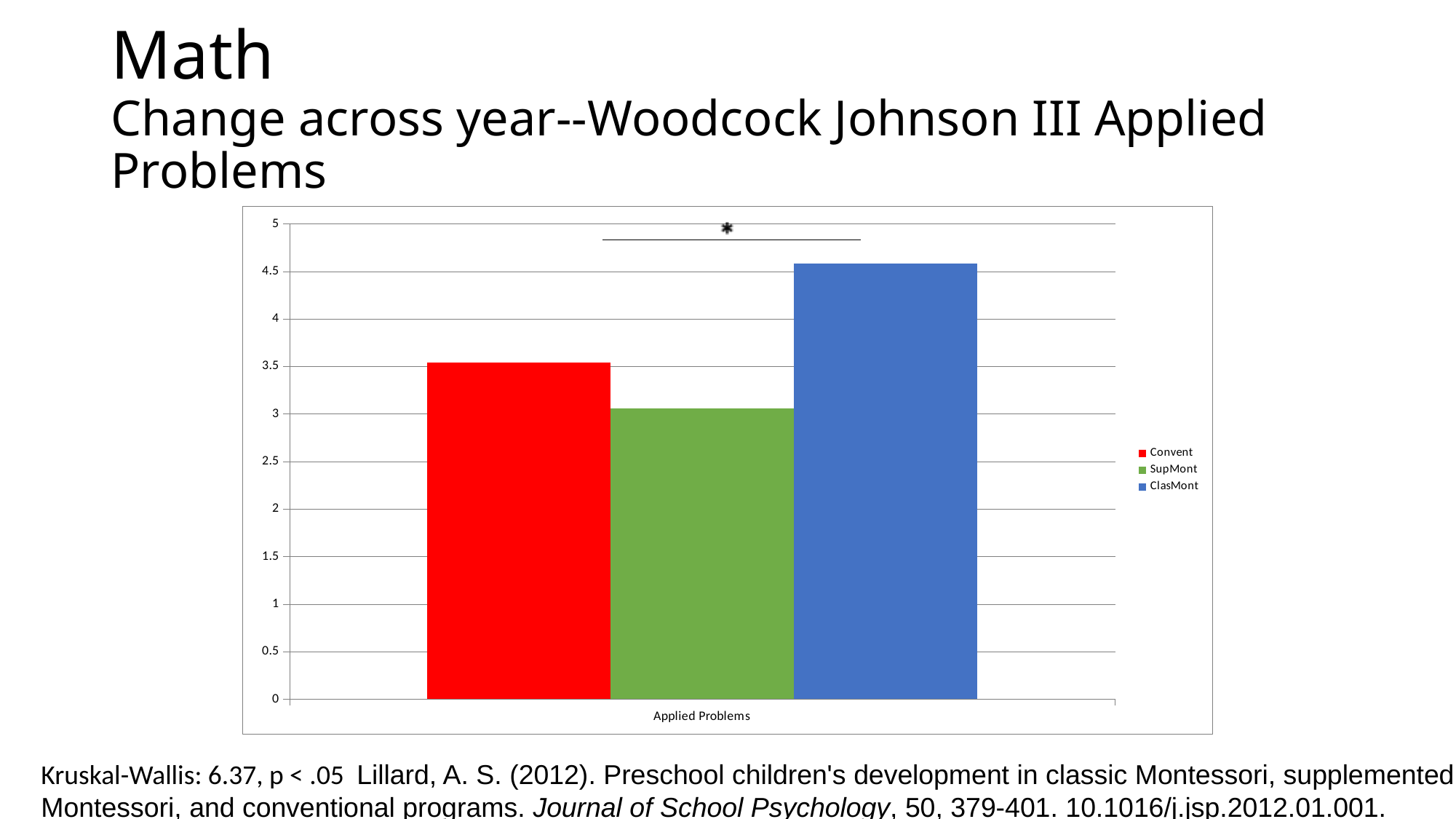
Is the value for SupMont greater or less than 3.5? less What colour is the bar for ClasMont? blue Which series has the lowest value for Applied Problems? SupMont Which is larger, the value for ClasMont or the value for Convent? ClasMont Is the value for Convent greater or less than 3? greater Which is larger, the value for Convent or the value for SupMont? Convent Which series has the highest value for Applied Problems? ClasMont What is the label of the category on the x axis? Applied Problems What kind of chart is shown on the slide? bar chart How many categories are shown on the x axis? 1 Is the value for ClasMont greater or less than 4.5? greater How many series does the legend list? 3